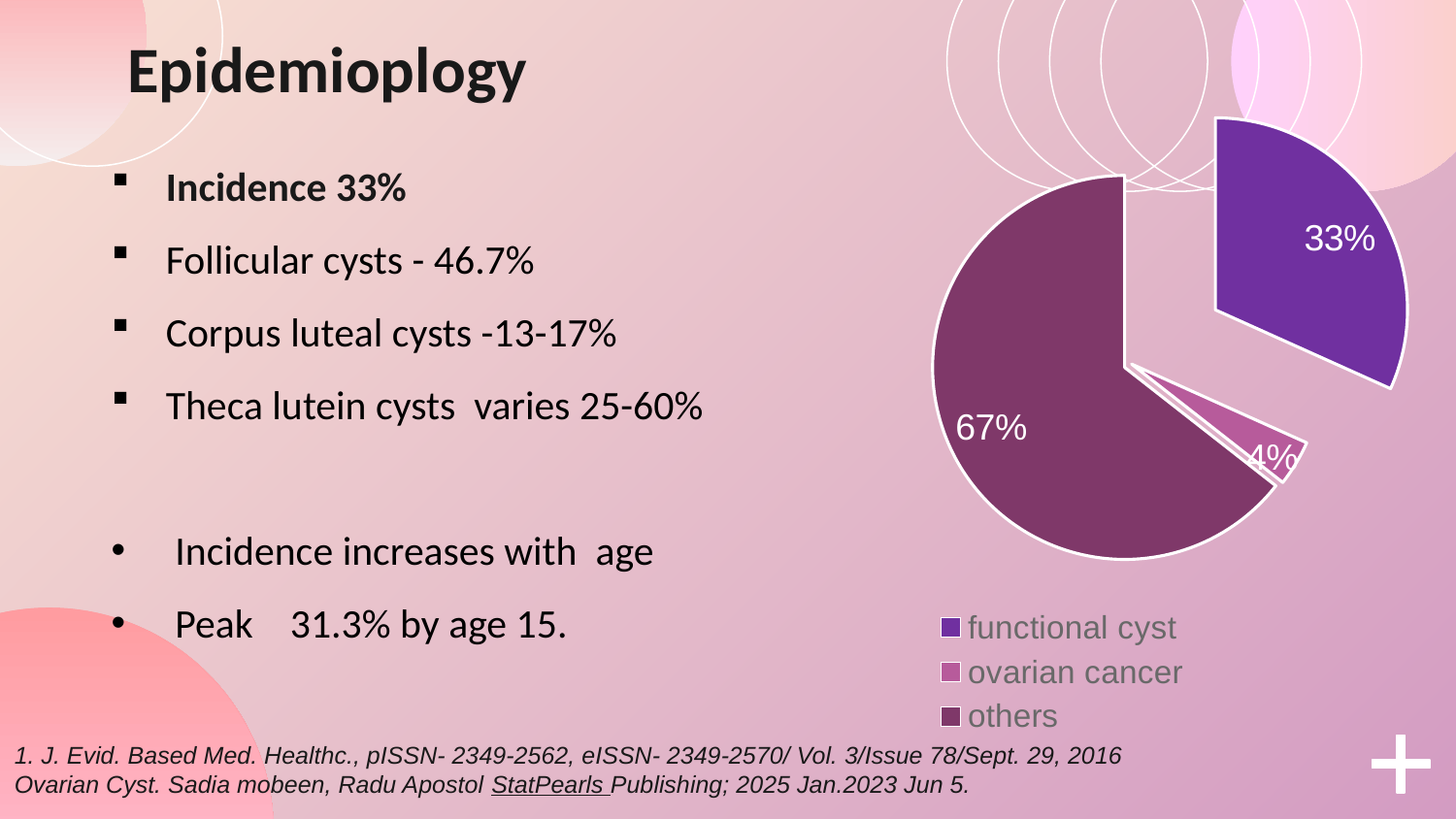
What is the difference in percentage points between the others slice and the functional cyst slice? 34 Which slice of the pie is the largest? others Which slice of the pie is the smallest? ovarian cancer Which legend entry is shown in the darkest colour? others How many slices does the pie chart have? 3 What is the difference in percentage points between the functional cyst slice and the ovarian cancer slice? 29 What kind of chart is shown on the slide? pie chart What share of the pie does the ovarian cancer slice represent? 4% Which is larger, the functional cyst slice or the ovarian cancer slice? functional cyst What share of the pie does the functional cyst slice represent? 33% What share of the pie does the others slice represent? 67% How many entries does the legend list? 3